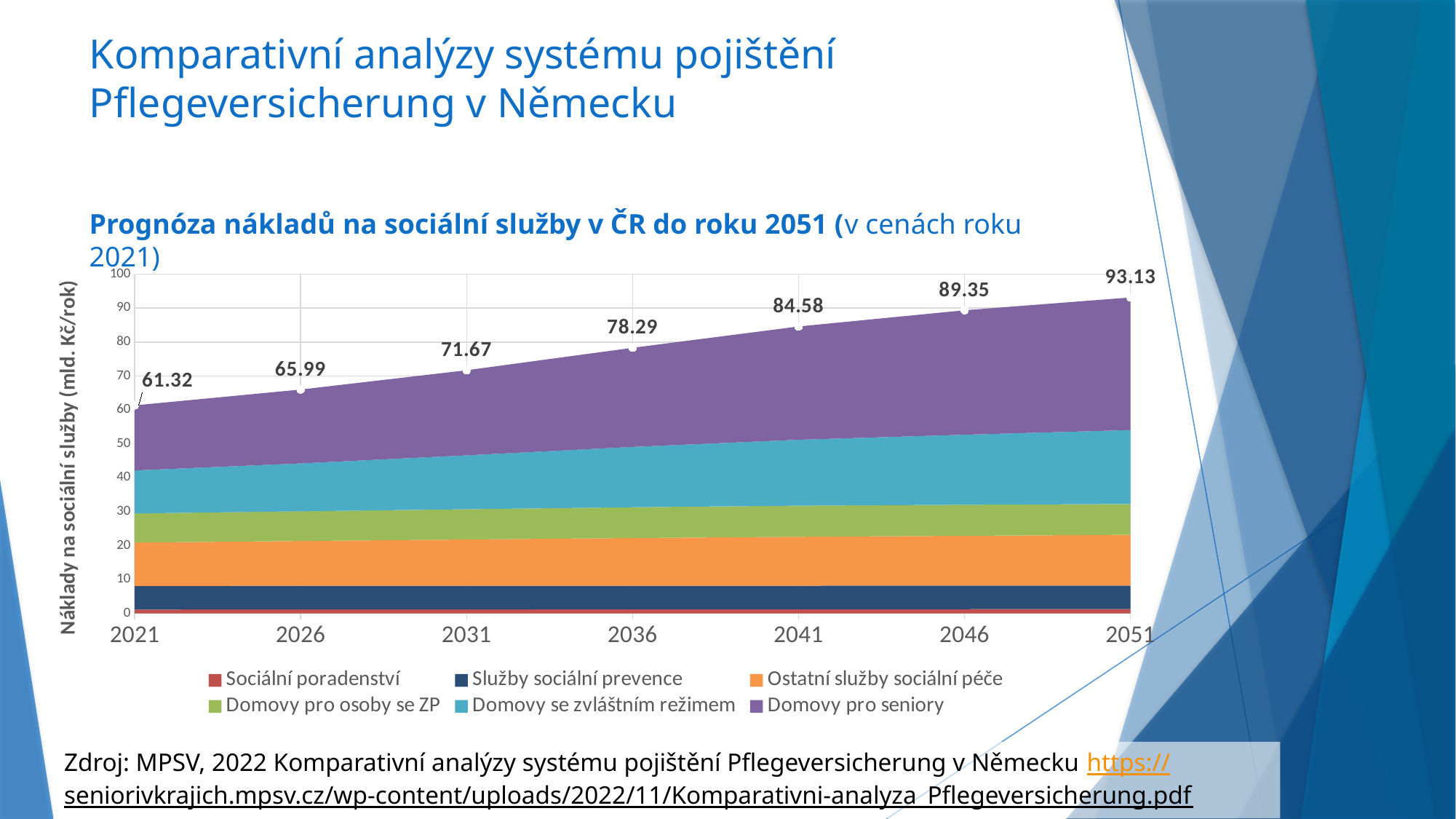
What is the total projected cost shown for 2051? 93.13 Do the total projected costs rise or fall from 2021 to 2051? rise Which year has the lowest total projected cost? 2021 What kind of chart is this? stacked area chart What is the total projected cost shown for 2036? 78.29 How many series does the legend list? 6 Is the total for 2031 greater or less than 70? greater By how much does the total projected cost increase from 2021 to 2051? 31.81 What is the total projected cost shown for 2021? 61.32 Which year has the highest total projected cost? 2051 What is the difference between the totals for 2041 and 2046? 4.77 How many years are shown on the x axis? 7